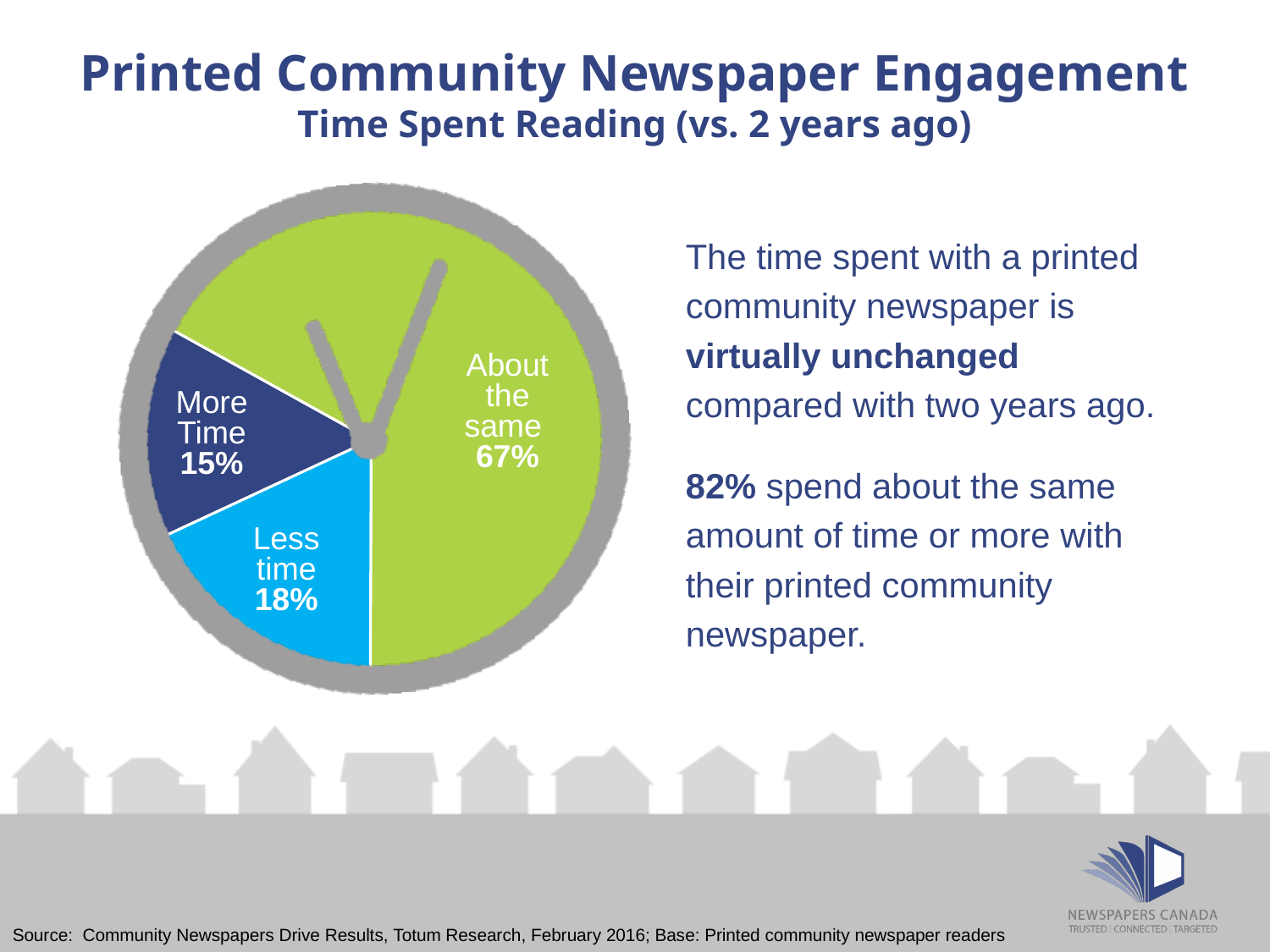
What kind of chart is shown on the slide? Pie chart What is the difference in percentage points between 'Less time' and 'More Time'? 3 Which category has the largest share of the pie? About the same What percentage of readers spend about the same amount of time reading? 67% How many categories are shown in the pie chart? 3 What percentage of readers spend less time reading? 18% Which category has the smallest share of the pie? More Time What is the difference in percentage points between 'About the same' and 'Less time'? 49 What colour is the 'About the same' slice of the pie? Green What is the combined share of readers who spend about the same amount of time or more? 82% Which is larger, the share for 'Less time' or the share for 'More Time'? Less time What percentage of readers spend more time reading? 15%